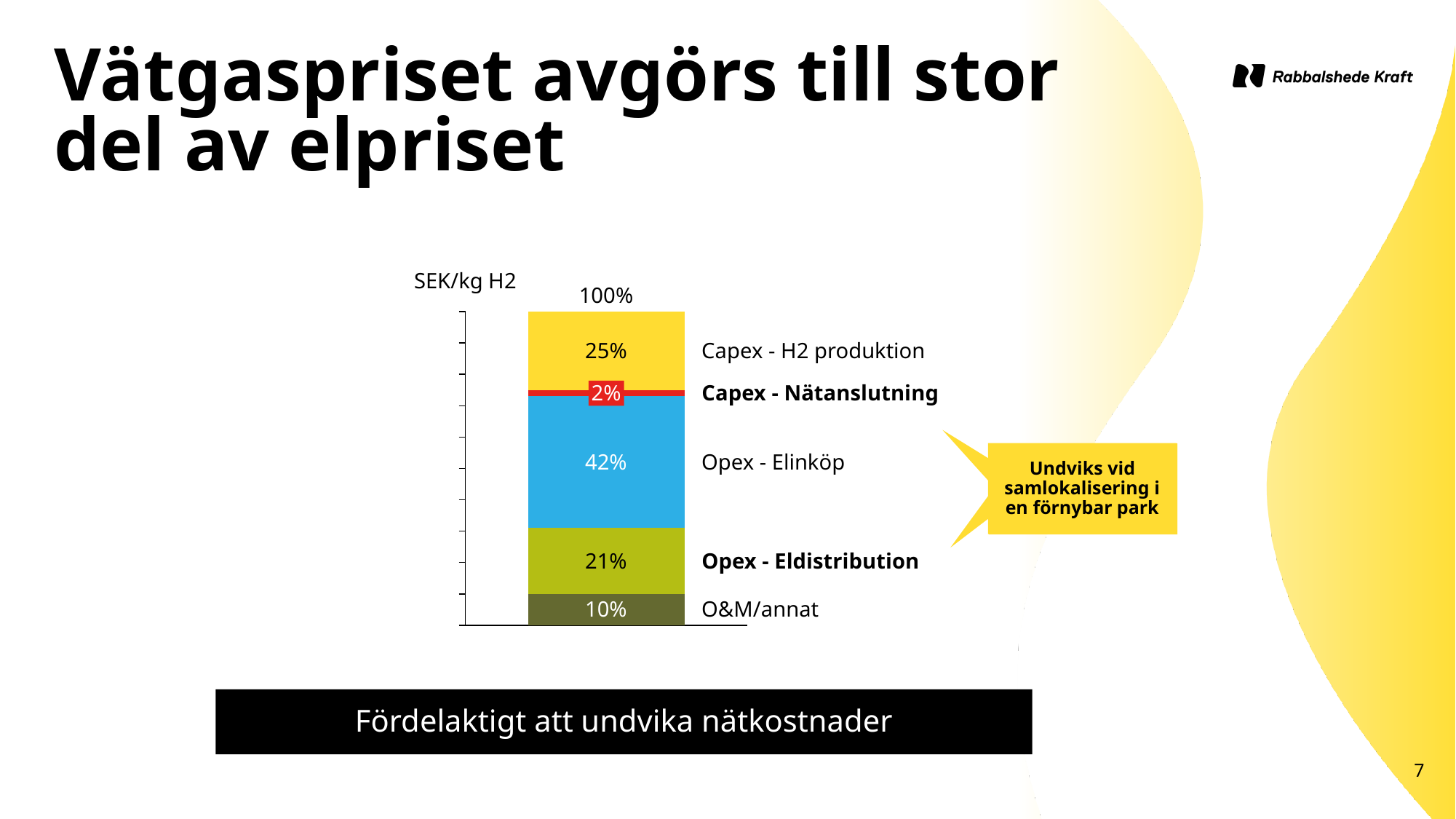
What share of the hydrogen cost is O&M/annat? 10% What share of the hydrogen cost is Opex - Eldistribution? 21% How many cost components make up the stacked bar? 5 What share of the hydrogen cost is Capex - H2 produktion? 25% What share of the hydrogen cost is Opex - Elinköp? 42% Which cost component has the smallest share of the stacked bar? Capex - Nätanslutning What is the difference in percentage points between Opex - Elinköp and Capex - H2 produktion? 17% What is the total of the stacked bar as labelled above it? 100% Which is larger, Opex - Eldistribution or O&M/annat? Opex - Eldistribution Which cost component has the largest share of the stacked bar? Opex - Elinköp What kind of chart is shown on the slide? Stacked bar chart What share of the hydrogen cost is Capex - Nätanslutning? 2%